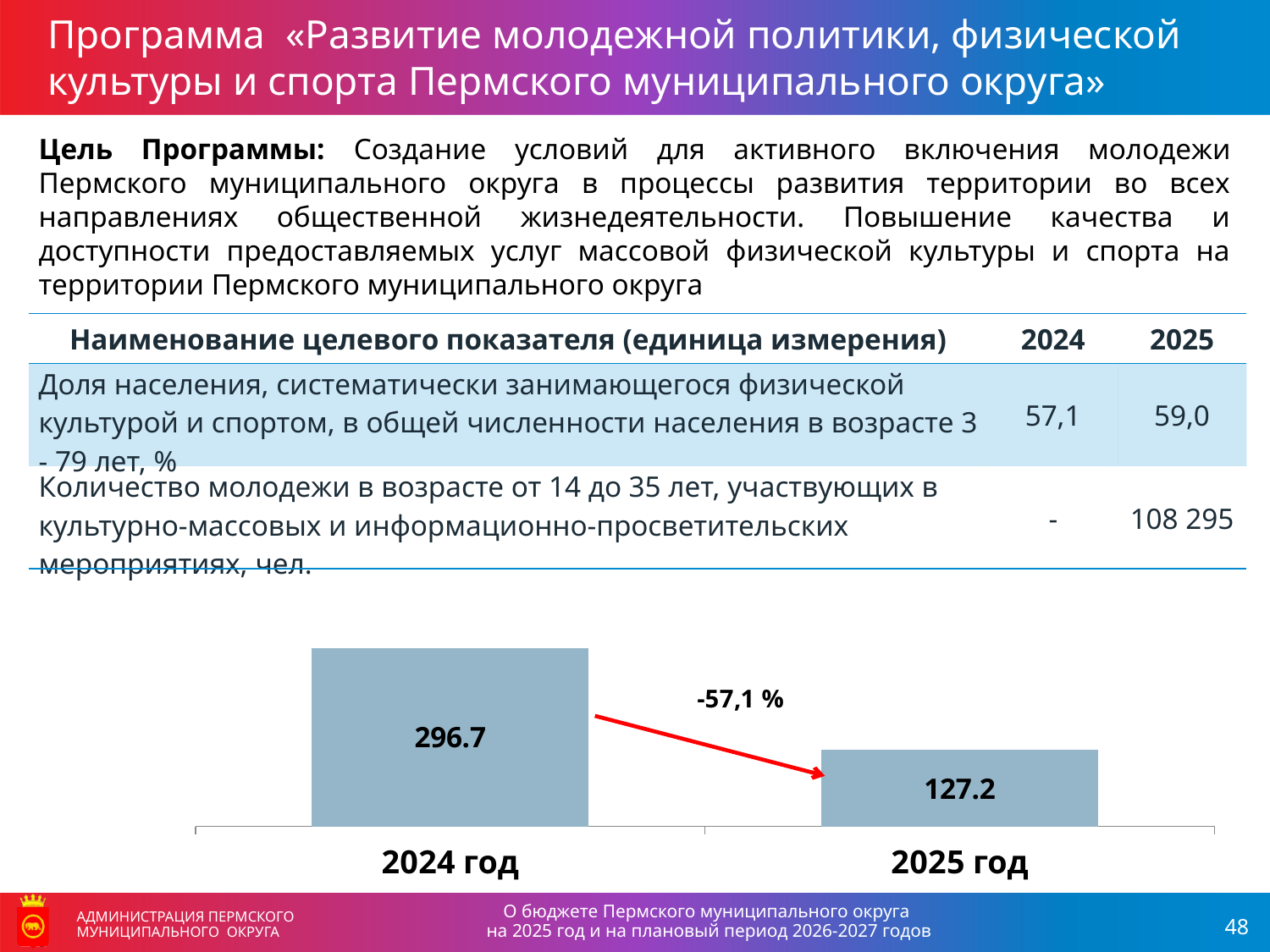
What is the difference between the values for 2024 год and 2025 год? 169.5 Which is larger, the value for 2024 год or the value for 2025 год? 2024 год What colour are the bars in the chart? light blue Which category has the lowest bar? 2025 год What is the value of the bar for 2024 год? 296.7 Which category has the highest bar? 2024 год What percentage change is written next to the arrow between the two bars? -57,1 % What kind of chart is shown on the slide? bar chart What is the value of the bar for 2025 год? 127.2 Do the values rise or fall from 2024 год to 2025 год? fall How many bars are shown in the chart? 2